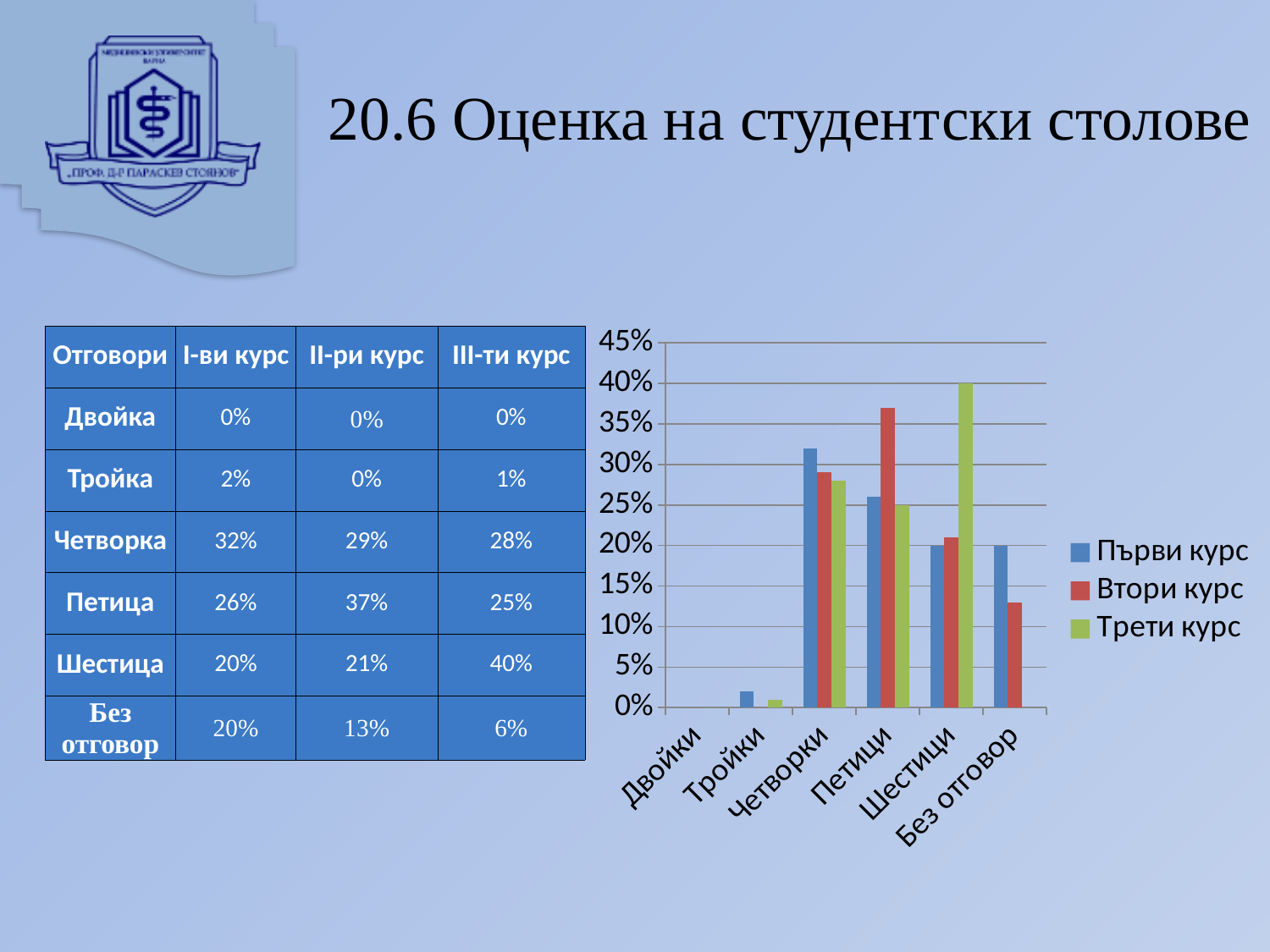
Which series has the lowest value in the Без отговор category? Трети курс What kind of chart is shown on the slide? bar chart In the Четворки category, which is larger: Първи курс or Трети курс? Първи курс What is the value for Трети курс in the Шестици category? 40% Is the value for Втори курс in the Без отговор category greater or less than 15%? less Which series has the highest value in the Петици category? Втори курс In the Шестици category, how much higher is Трети курс than Първи курс? 20% What is the value for Втори курс in the Петици category? 37% How many series does the chart legend list? 3 How many categories are shown along the x axis of the chart? 6 Is the value for Втори курс in the Петици category greater or less than 35%? greater Which category has the highest value for Трети курс? Шестици